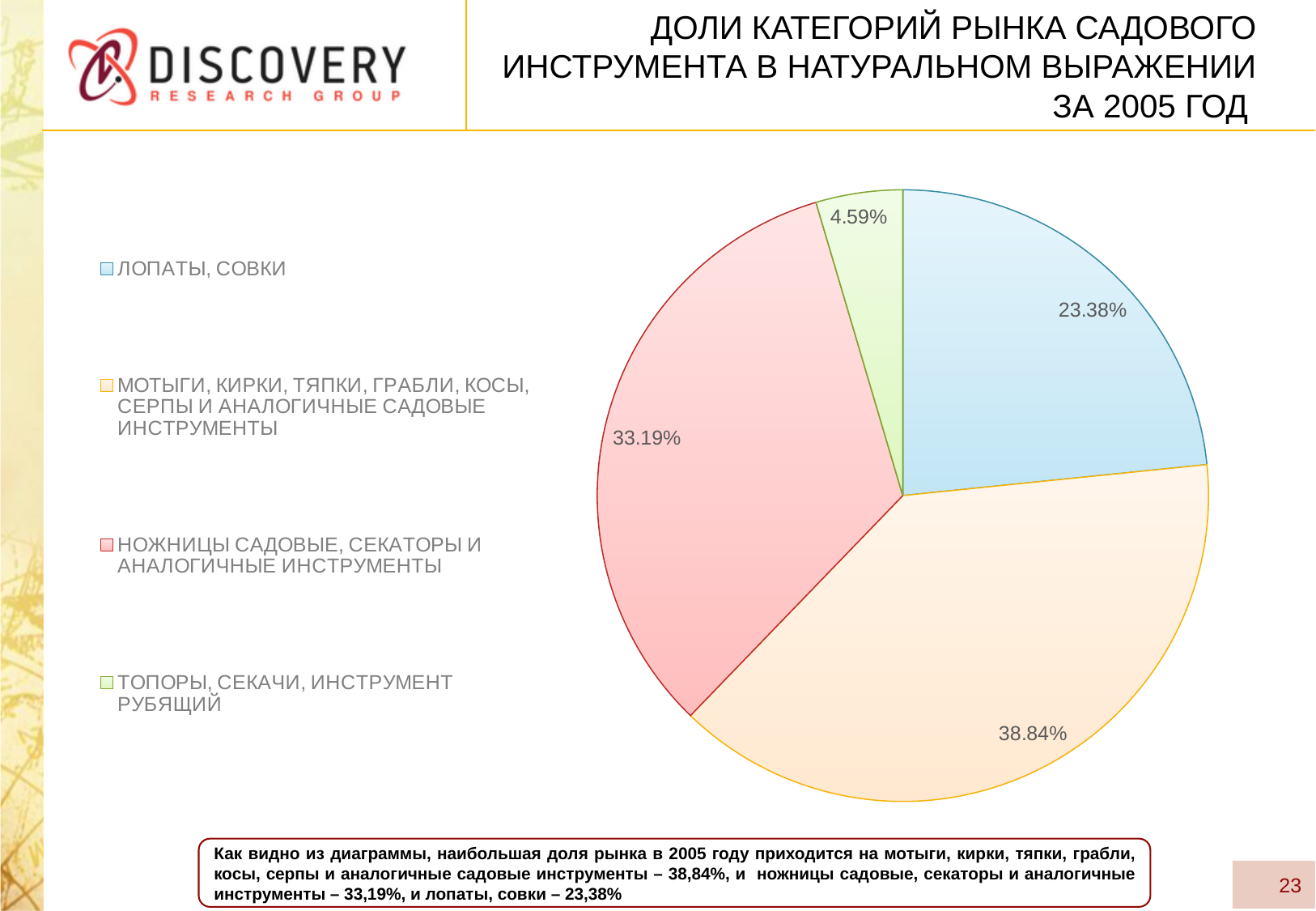
What type of chart is shown on the slide? pie chart What is the difference in percentage points between the shares of ЛОПАТЫ, СОВКИ and ТОПОРЫ, СЕКАЧИ, ИНСТРУМЕНТ РУБЯЩИЙ? 18.79 How many categories are shown in the pie chart? 4 Which has a larger share: ЛОПАТЫ, СОВКИ or НОЖНИЦЫ САДОВЫЕ, СЕКАТОРЫ И АНАЛОГИЧНЫЕ ИНСТРУМЕНТЫ? НОЖНИЦЫ САДОВЫЕ, СЕКАТОРЫ И АНАЛОГИЧНЫЕ ИНСТРУМЕНТЫ What share of the market is held by ТОПОРЫ, СЕКАЧИ, ИНСТРУМЕНТ РУБЯЩИЙ? 4.59% What share of the market is held by МОТЫГИ, КИРКИ, ТЯПКИ, ГРАБЛИ, КОСЫ, СЕРПЫ И АНАЛОГИЧНЫЕ САДОВЫЕ ИНСТРУМЕНТЫ? 38.84% What is the difference in percentage points between the shares of МОТЫГИ, КИРКИ, ТЯПКИ, ГРАБЛИ, КОСЫ, СЕРПЫ И АНАЛОГИЧНЫЕ САДОВЫЕ ИНСТРУМЕНТЫ and НОЖНИЦЫ САДОВЫЕ, СЕКАТОРЫ И АНАЛОГИЧНЫЕ ИНСТРУМЕНТЫ? 5.65 Which category has the largest share of the market? МОТЫГИ, КИРКИ, ТЯПКИ, ГРАБЛИ, КОСЫ, СЕРПЫ И АНАЛОГИЧНЫЕ САДОВЫЕ ИНСТРУМЕНТЫ What share of the market is held by НОЖНИЦЫ САДОВЫЕ, СЕКАТОРЫ И АНАЛОГИЧНЫЕ ИНСТРУМЕНТЫ? 33.19% What share of the garden tool market in 2005 is held by ЛОПАТЫ, СОВКИ? 23.38% Which colour represents ЛОПАТЫ, СОВКИ in the pie chart? blue Which category has the smallest share of the market? ТОПОРЫ, СЕКАЧИ, ИНСТРУМЕНТ РУБЯЩИЙ